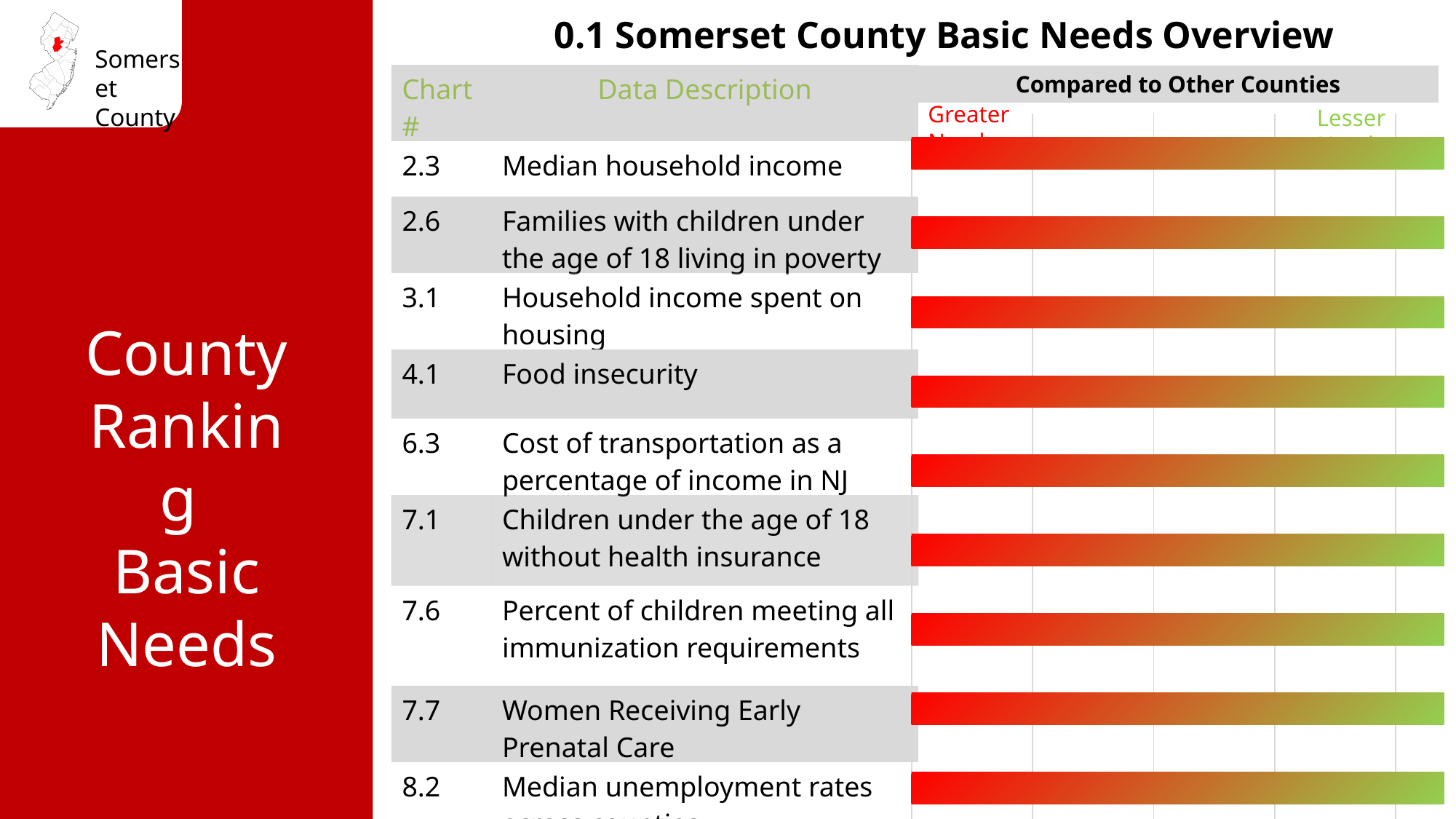
Which data description is listed for chart number 8.2? Median unemployment rates What kind of chart is shown on the slide? bar chart How many data description rows (bars) are shown in the chart? 9 What is the chart number listed for "Food insecurity"? 4.1 What is the heading above the bars on the right side of the table? Compared to Other Counties What is the title of the chart on the slide? 0.1 Somerset County Basic Needs Overview What is the chart number listed for "Median household income"? 2.3